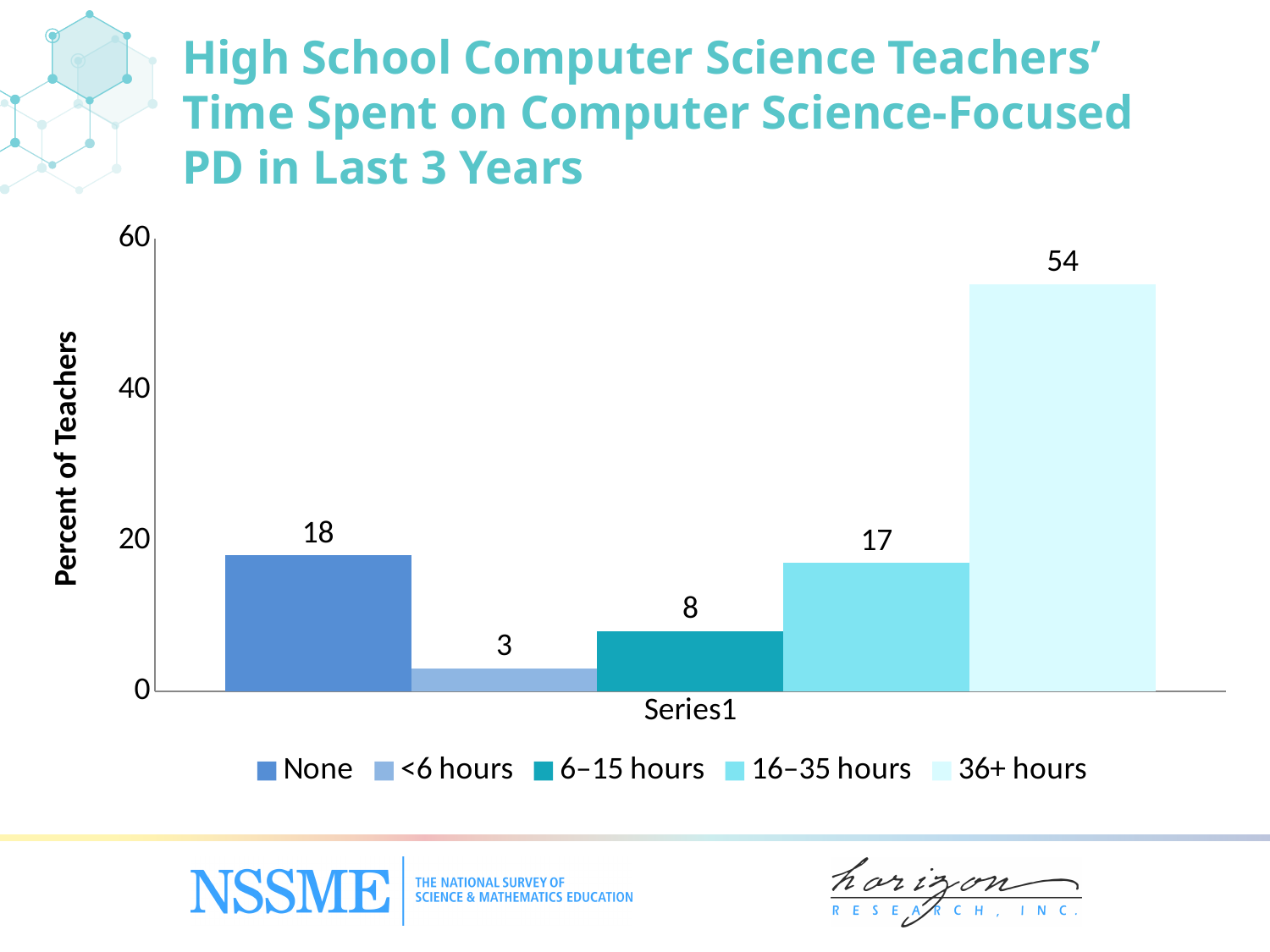
What percent of teachers reported 36+ hours of computer science-focused PD? 54 Which category has the lowest percent of teachers? <6 hours How many categories does the legend list? 5 Which category has the highest percent of teachers? 36+ hours Is the value for 36+ hours greater or less than 40? greater Which is larger, the value for None or the value for 16–35 hours? None What percent of teachers reported no computer science-focused PD in the last 3 years? 18 What is the difference between the 36+ hours value and the None value? 36 What is the value for the <6 hours category? 3 What is the value for the 6–15 hours category? 8 What is the label on the vertical axis? Percent of Teachers What kind of chart is shown on the slide? bar chart